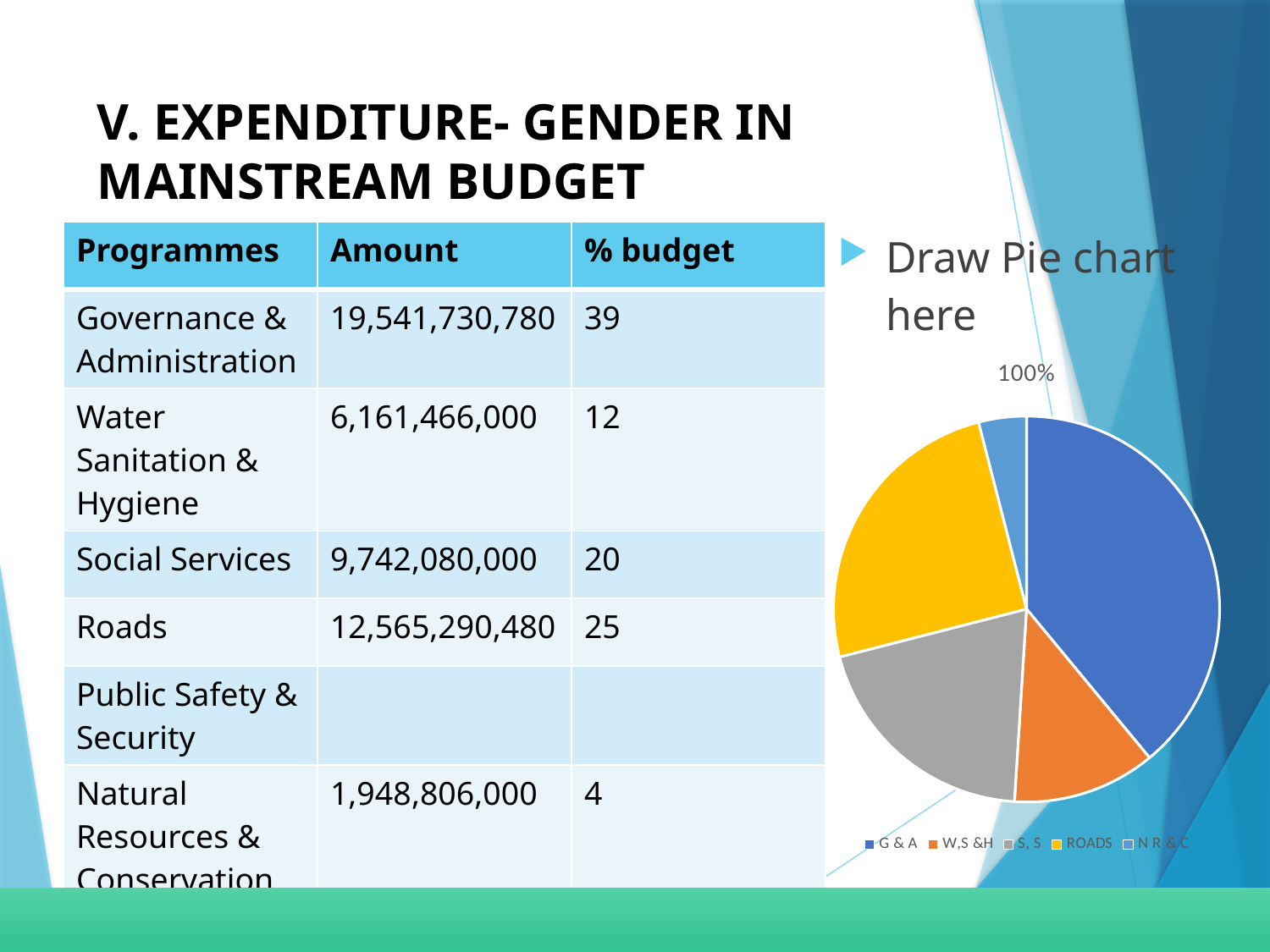
What colour is the G & A slice in the pie chart? blue What text appears as the title above the pie chart? 100% Which category has the smallest slice in the pie chart? N R & C How many categories does the pie chart's legend list? 5 In the pie chart, which slice is larger: S, S or W,S &H? S, S In the pie chart, which slice is larger: ROADS or W,S &H? ROADS What kind of chart is shown on the right of the slide? pie chart In the pie chart, which slice is larger: G & A or N R & C? G & A Which category has the largest slice in the pie chart? G & A